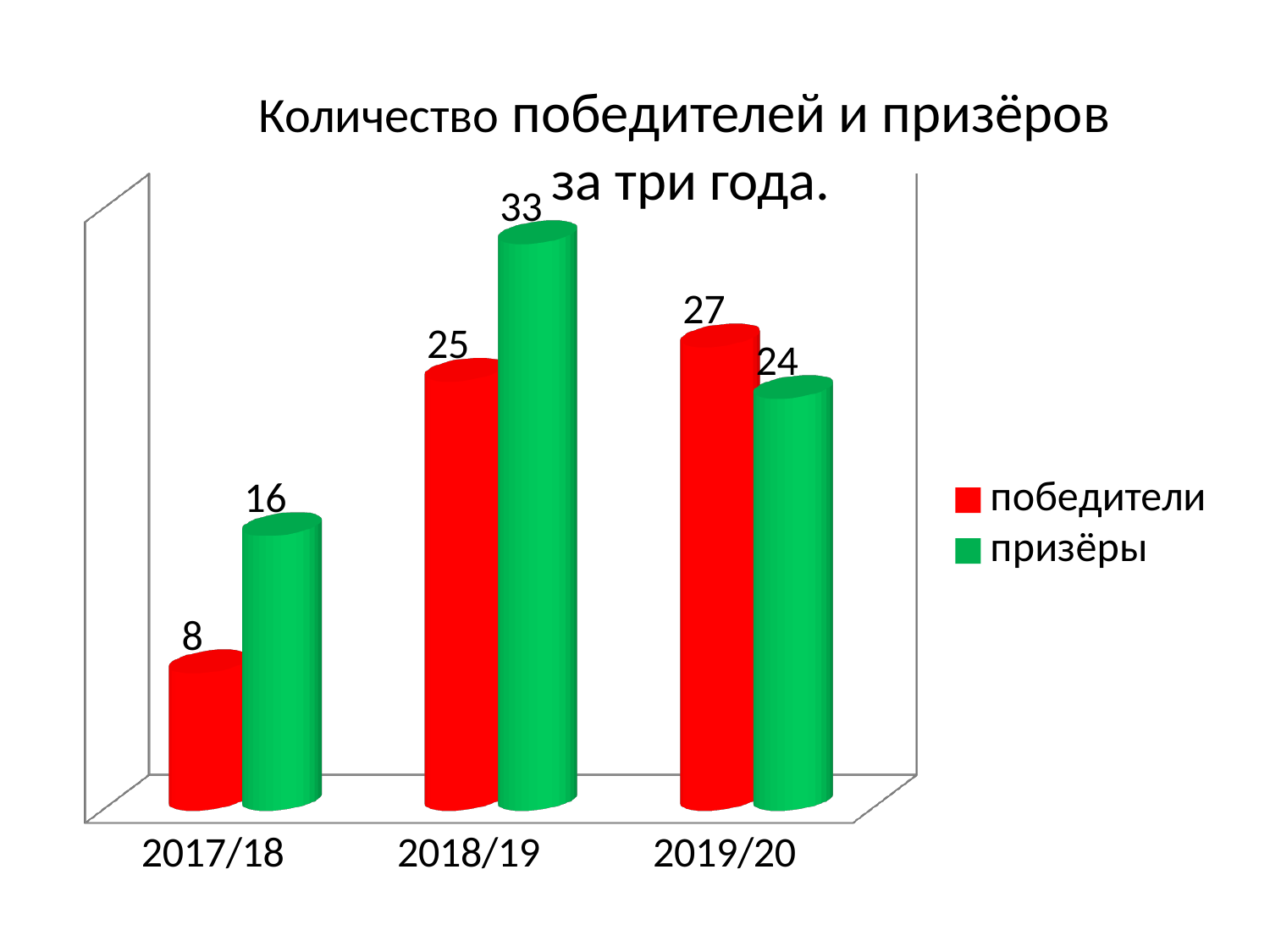
How many series does the legend list? 2 In which year is the value for призёры highest? 2018/19 What is the value for призёры in 2018/19? 33 What kind of chart is shown on the slide? bar chart What is the value for победители in 2019/20? 27 How many years are shown on the x axis? 3 What is the value for победители in 2017/18? 8 In which year is the value for победители lowest? 2017/18 Which is larger in 2019/20, победители or призёры? победители What is the difference between призёры and победители in 2017/18? 8 Which colour represents призёры in the legend? green What is the value for призёры in 2019/20? 24